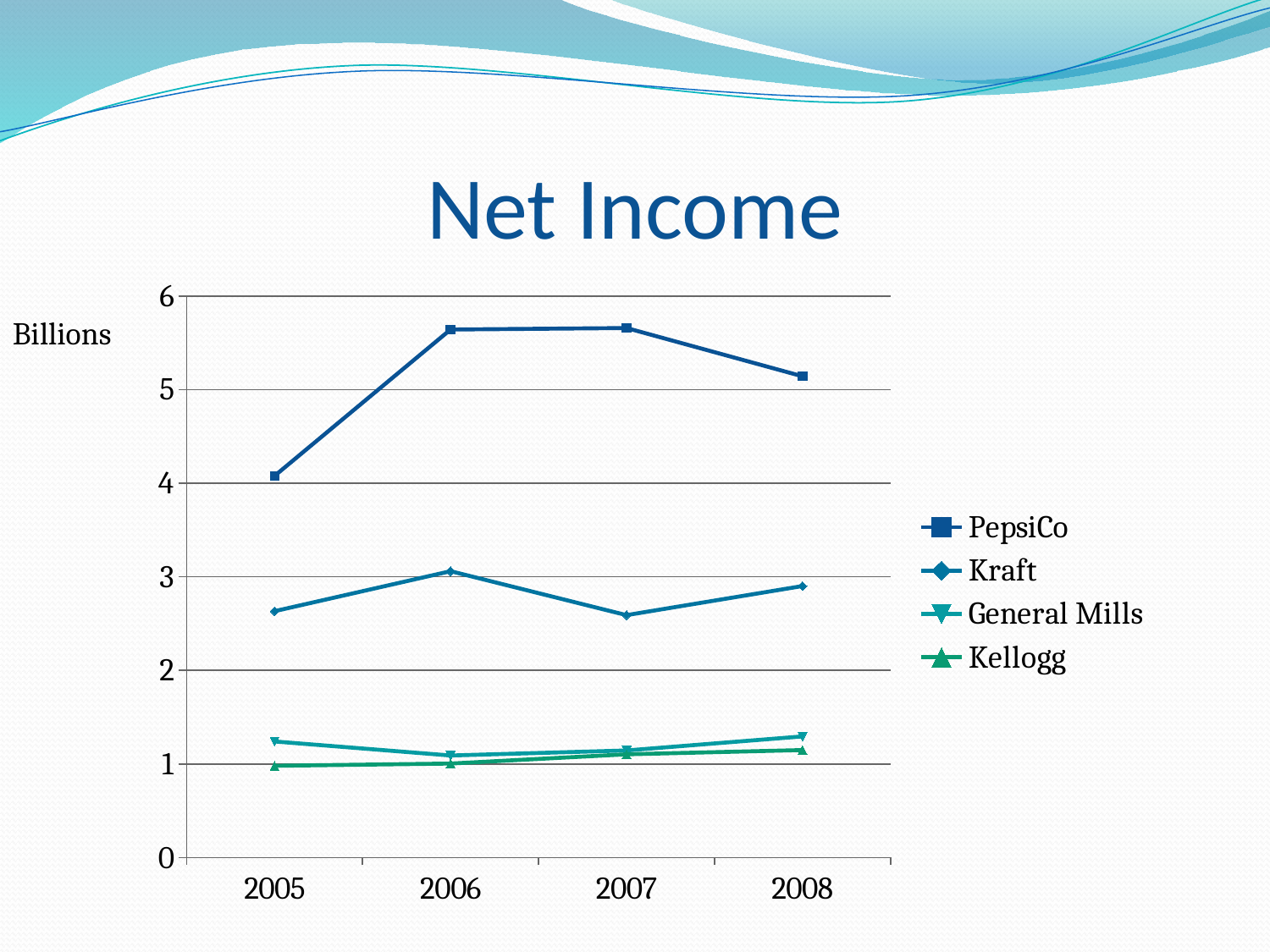
Which company has the highest net income in 2008? PepsiCo What unit label is shown next to the y axis? Billions What kind of chart is shown on the slide? line chart Which company has the lowest net income in 2005? Kellogg How many series does the legend list? 4 Is the value for Kraft in 2007 greater or less than 3? less Is the value for PepsiCo in 2005 greater or less than 5? less Which is larger for Kraft: the value in 2006 or the value in 2007? 2006 Is the value for General Mills in 2005 greater or less than 1? greater Does the Kellogg line generally rise or fall from 2005 to 2008? rise How many years are shown on the x axis? 4 Does the PepsiCo line rise or fall from 2007 to 2008? fall